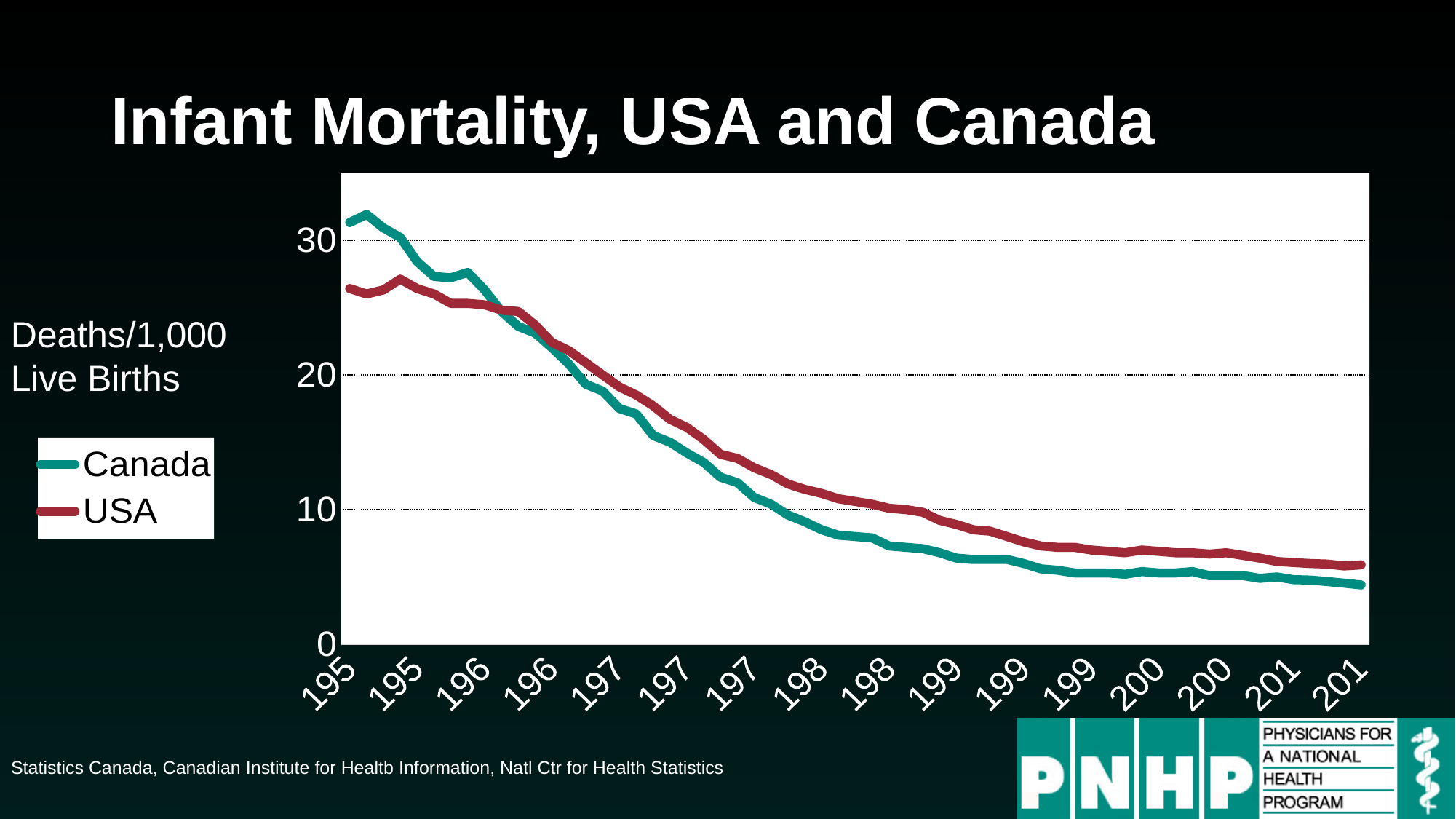
What is the title of the chart? Infant Mortality, USA and Canada Do the values for USA rise or fall from left to right along the x axis? fall Is the value for USA at the right end of the chart greater or less than 10? less Do the values for Canada rise or fall from left to right along the x axis? fall Is the value for USA at the left end of the chart greater or less than 20? greater What kind of chart is shown on the slide? line chart Is the value for Canada at the right end of the chart greater or less than 10? less How many series does the legend list? 2 At the left end of the chart, which series has the higher value, Canada or USA? Canada At the right end of the chart, which series has the higher value, Canada or USA? USA What unit is the y axis measured in, according to the label on the slide? Deaths/1,000 Live Births